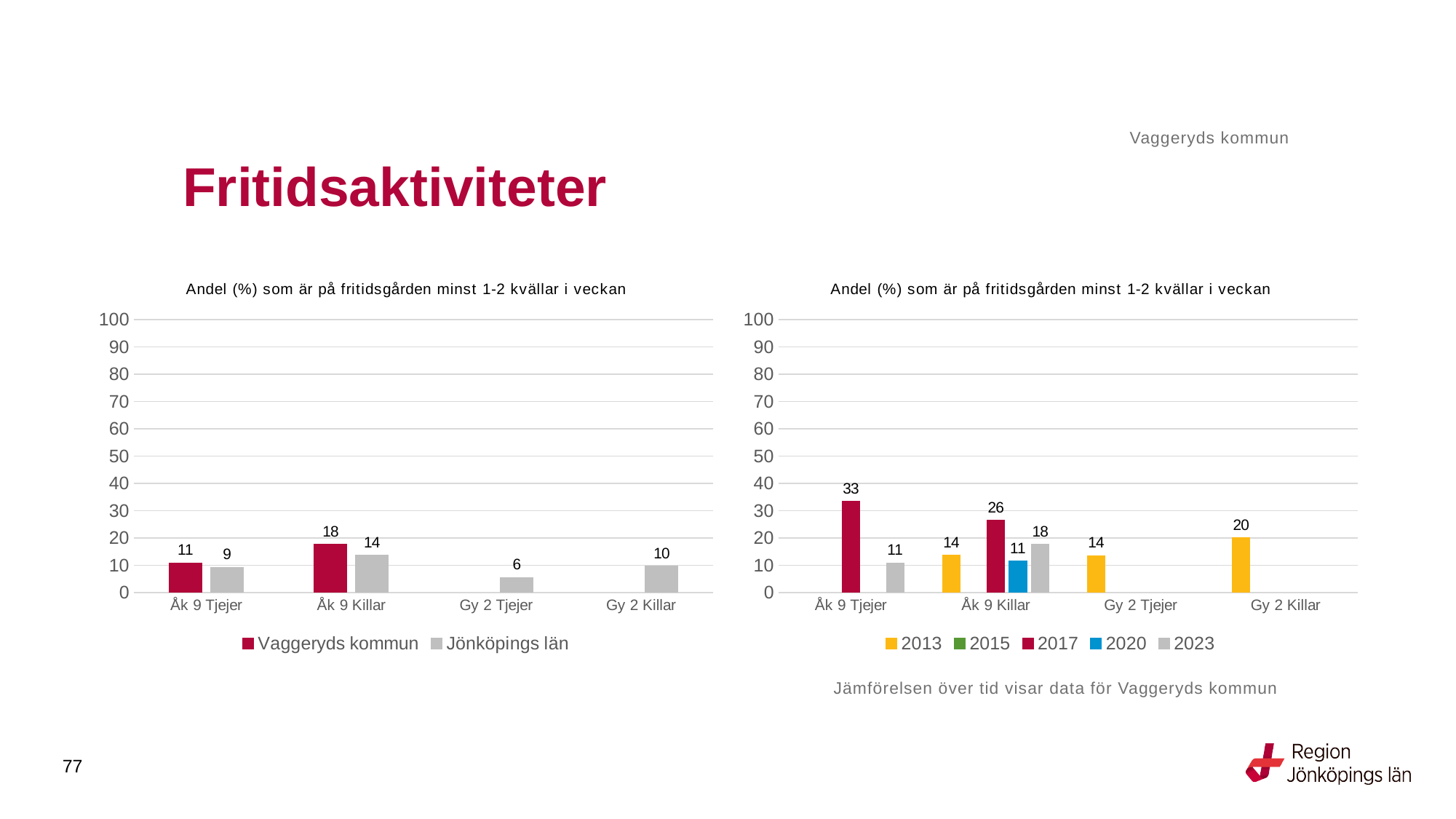
In the left chart, what is the difference between Vaggeryds kommun and Jönköpings län for Åk 9 Tjejer? 2 In the left chart, which category has the lowest value for Jönköpings län? Gy 2 Tjejer In the left chart, what is the value for Vaggeryds kommun for Åk 9 Killar? 18 In the right chart, what is the value for 2023 for Åk 9 Killar? 18 In the right chart, what is the value for 2013 for Gy 2 Killar? 20 In the right chart, which year has the highest value for Åk 9 Killar? 2017 In the right chart, what is the value for 2017 for Åk 9 Tjejer? 33 What kind of chart is the right chart? Bar chart In the left chart, what is the value for Jönköpings län for Gy 2 Tjejer? 6 In the right chart, how many series does the legend list? 5 In the right chart, what is the difference between the 2017 and 2023 values for Åk 9 Tjejer? 22 In the left chart, how many series does the legend list? 2